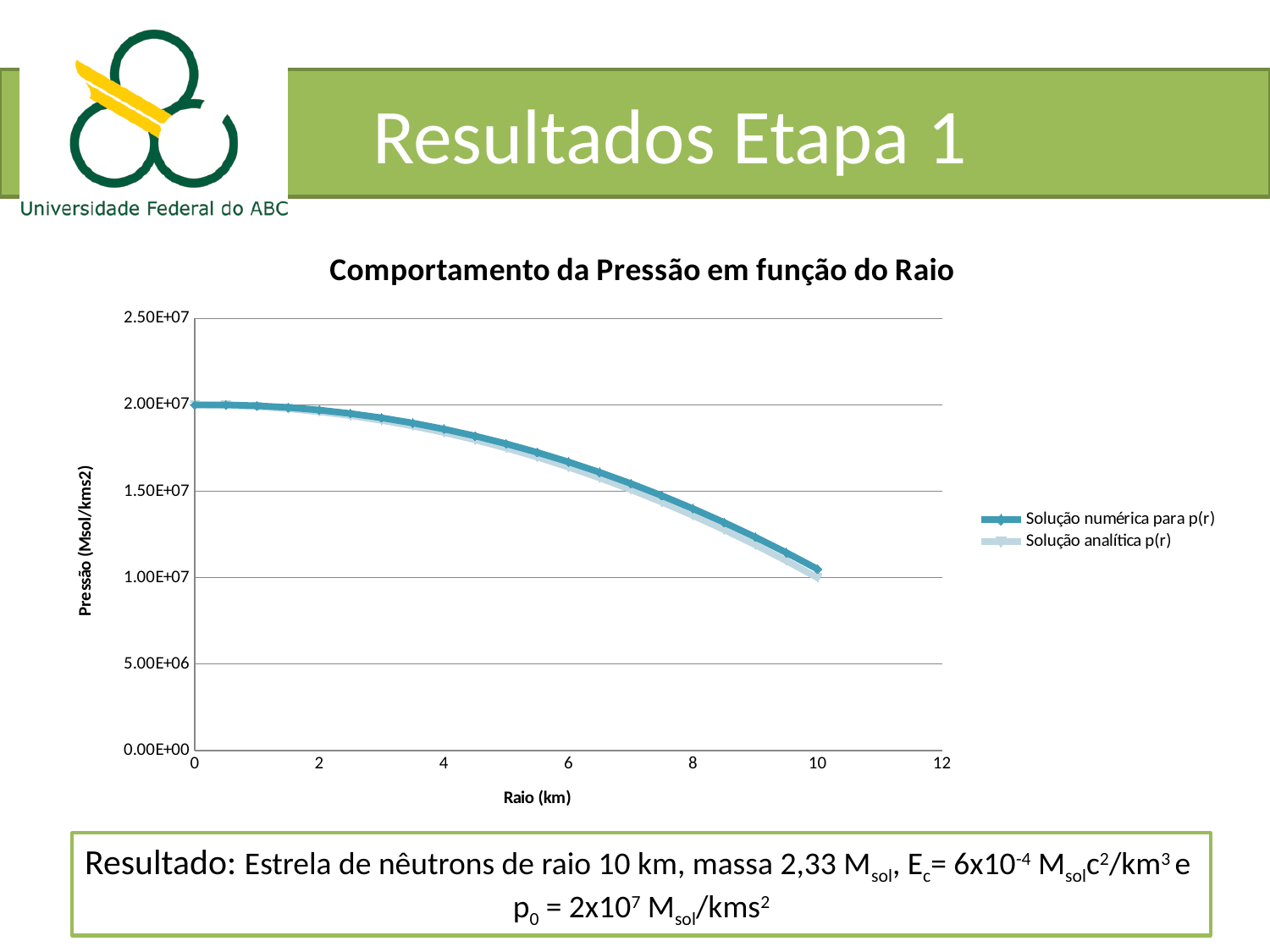
What is the title of the chart? Comportamento da Pressão em função do Raio Which series has the higher value at a radius of 10 km, 'Solução numérica para p(r)' or 'Solução analítica p(r)'? Solução numérica para p(r) At which radius is the pressure highest? 0 How many series does the legend list? 2 Is the value of 'Solução analítica p(r)' at a radius of 8 km greater or less than 1.50E+07? less Does the pressure rise or fall as the radius increases? fall Is the value of 'Solução numérica para p(r)' at a radius of 10 km greater or less than 1.50E+07? less What is the label of the x axis? Raio (km) Is the value of 'Solução analítica p(r)' at a radius of 2 km greater or less than 1.50E+07? greater What is the pressure of the 'Solução numérica para p(r)' series at a radius of 0 km? 2.00E+07 What kind of chart is shown on the slide? line chart